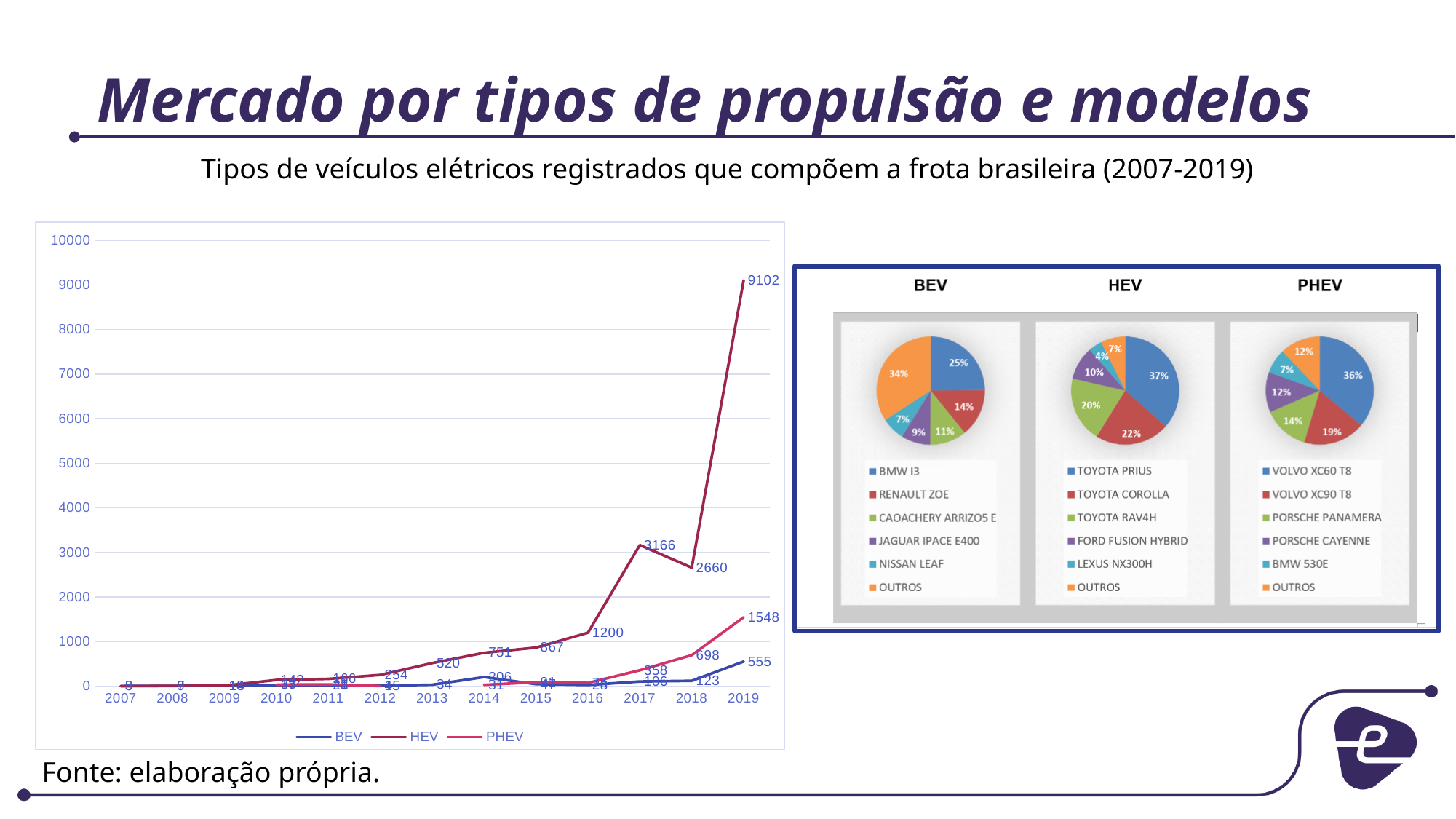
In the line chart, how many series does the legend list? 3 In the line chart, what is the BEV value for 2019? 555 In the line chart, which series has the highest value in 2019? HEV In the line chart, does the HEV series rise or fall between 2018 and 2019? rise In the BEV pie chart, what share does BMW I3 have? 25% In the line chart, what is the PHEV value for 2019? 1548 What type of chart is the large chart on the left of the slide? line chart In the line chart, how many years are shown on the x axis? 13 In the HEV pie chart, which model has the largest share? TOYOTA PRIUS In the PHEV pie chart, what share does VOLVO XC90 T8 have? 19% In the line chart, what is the difference between the HEV values for 2017 and 2018? 506 In the line chart, what is the HEV value for 2019? 9102